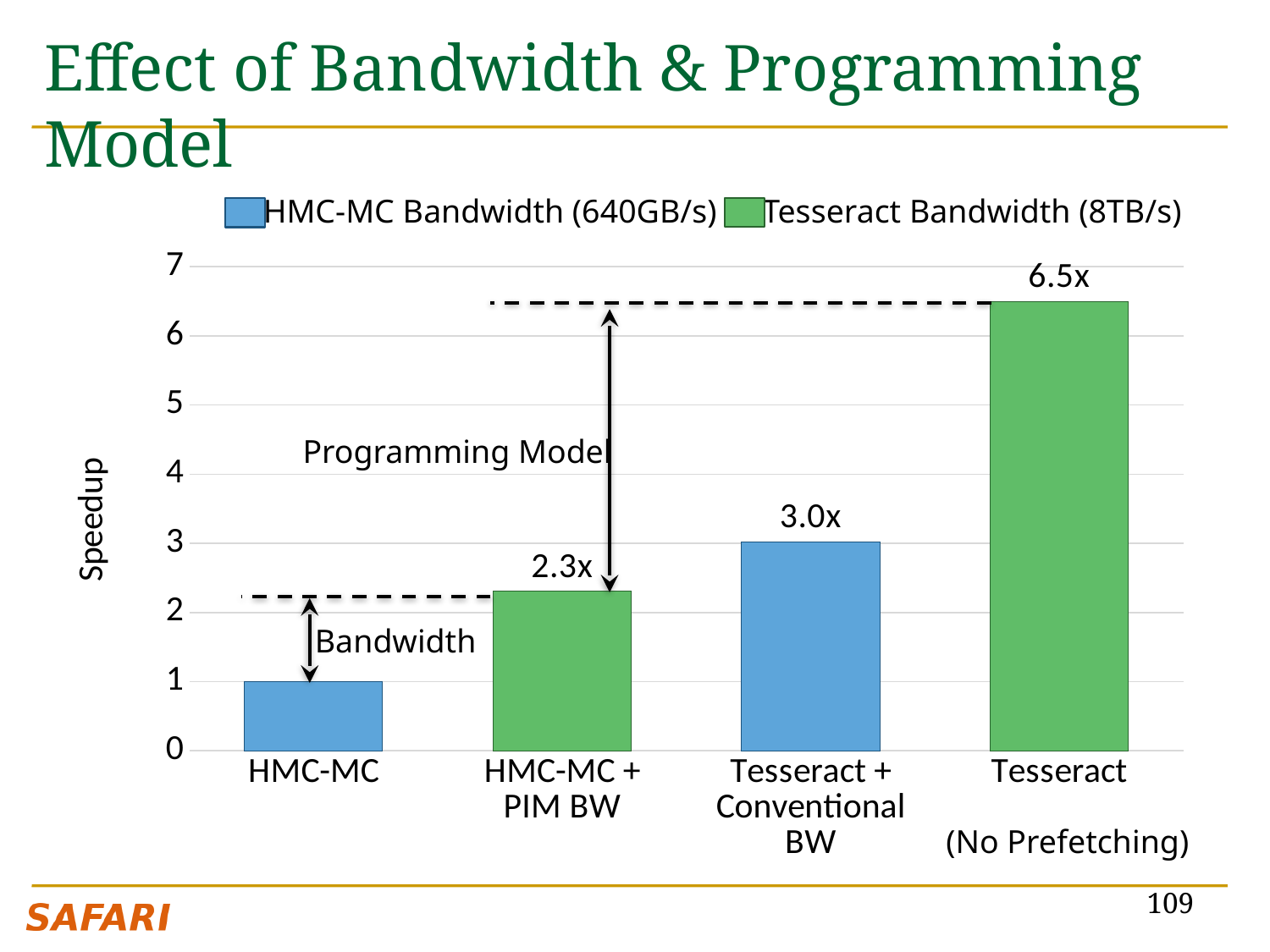
How many configurations (bars) are shown in the chart? 4 What kind of chart is shown on the slide? bar chart What is the speedup for Tesseract + Conventional BW? 3.0x How many series does the legend list? 2 What is the label of the vertical axis? Speedup What is the speedup for HMC-MC + PIM BW? 2.3x What is the speedup for Tesseract (No Prefetching)? 6.5x What is the difference in speedup between Tesseract (No Prefetching) and Tesseract + Conventional BW? 3.5x Which configuration has the highest speedup? Tesseract (No Prefetching) Which has a larger speedup, HMC-MC + PIM BW or Tesseract + Conventional BW? Tesseract + Conventional BW Which configuration has the lowest speedup? HMC-MC Is the speedup for HMC-MC greater or less than 2? less